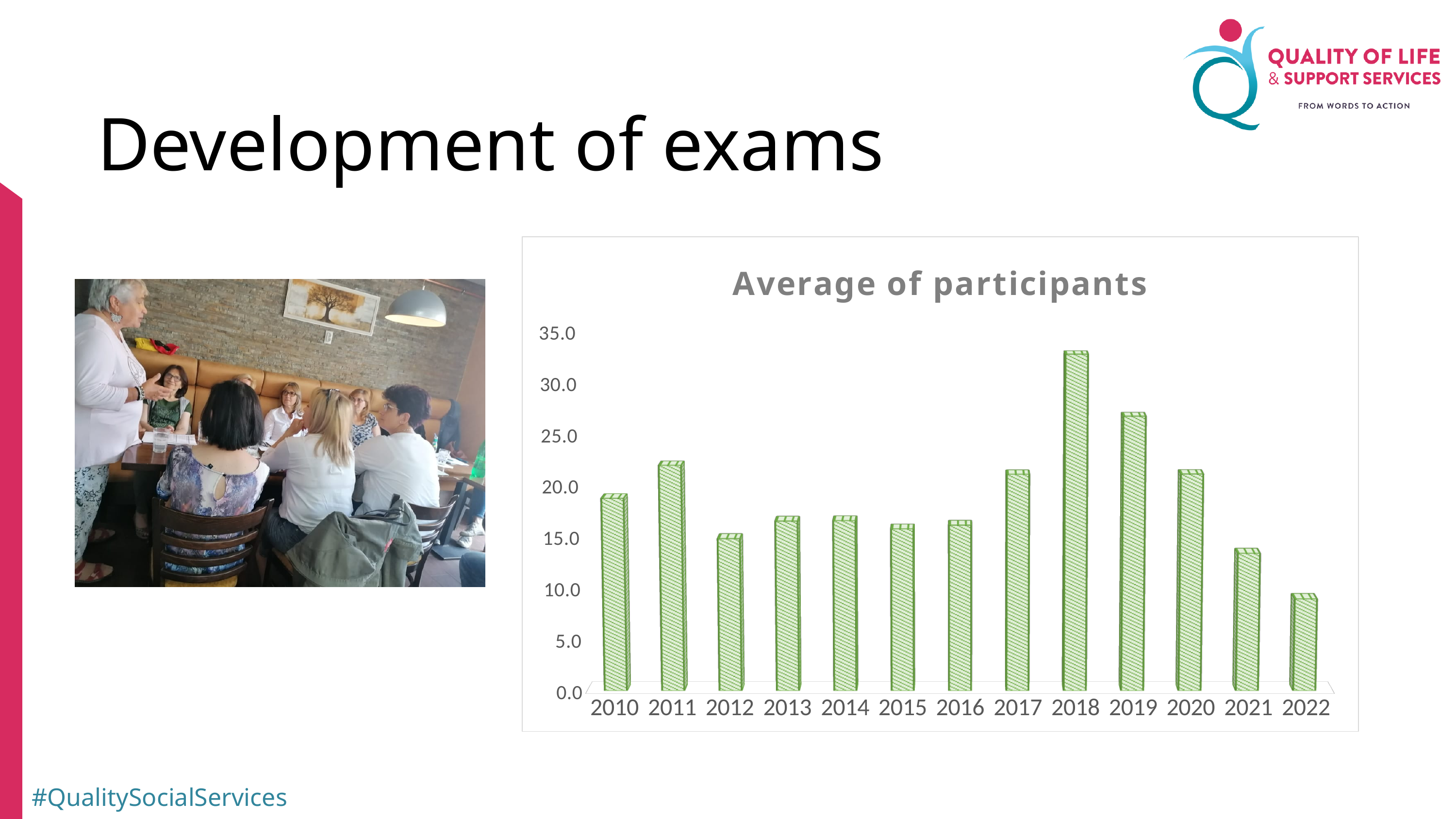
Which year has a higher average of participants, 2011 or 2012? 2011 Which year has the highest average of participants? 2018 Is the value for 2012 greater or less than 20.0? less How many years are shown on the x axis of the chart? 13 Is the value for 2022 greater or less than 10.0? less What kind of chart is shown on the slide? bar chart Which year has the lowest average of participants? 2022 Is the value for 2011 greater or less than 20.0? greater Do the values rise or fall from 2018 to 2022? fall What is the title of the chart? Average of participants Which year has a higher average of participants, 2018 or 2019? 2018